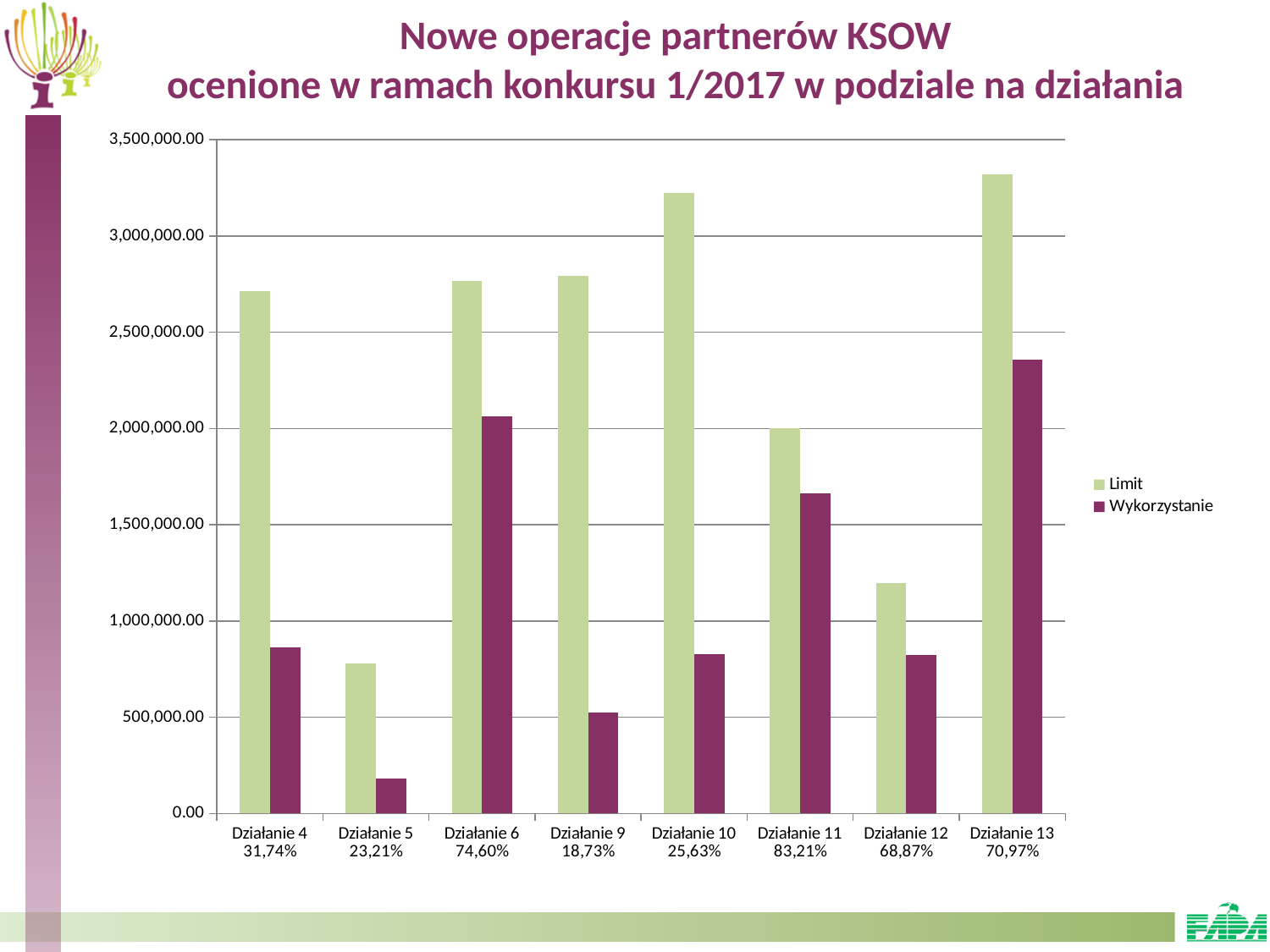
Which category has the highest Wykorzystanie value? Działanie 13 How many series does the legend list? 2 Which is larger: the Wykorzystanie value for Działanie 11 or for Działanie 10? Działanie 11 Which category has the lowest Wykorzystanie value? Działanie 5 Which category has the lowest Limit value? Działanie 5 What percentage is printed under the label for Działanie 9? 18,73% Which category has the highest Limit value? Działanie 13 How many categories (działania) are shown on the x axis? 8 What percentage is printed under the label for Działanie 11? 83,21% Is the Limit value for Działanie 10 greater or less than 3,000,000.00? greater Is the Wykorzystanie value for Działanie 5 greater or less than 500,000.00? less What type of chart is shown on the slide? bar chart